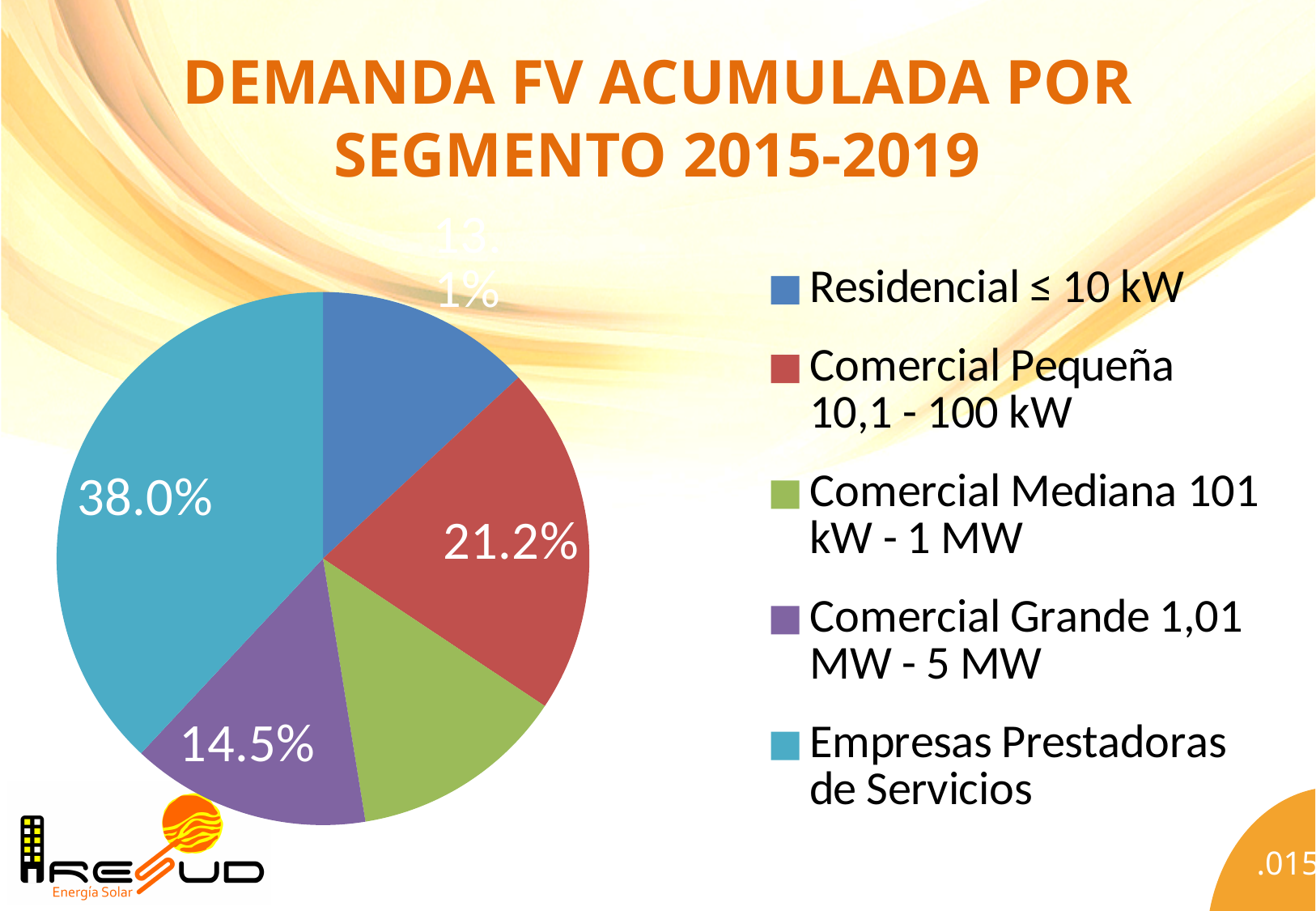
What share of the pie does Residencial ≤ 10 kW represent? 13.1% What is the difference in percentage points between the Comercial Pequeña 10,1 - 100 kW share and the Comercial Grande 1,01 MW - 5 MW share? 6.7 percentage points Which segment has the largest share of the pie? Empresas Prestadoras de Servicios Which has a larger share: Comercial Pequeña 10,1 - 100 kW or Comercial Grande 1,01 MW - 5 MW? Comercial Pequeña 10,1 - 100 kW What share of the pie does Comercial Pequeña 10,1 - 100 kW represent? 21.2% What kind of chart is shown on the slide? Pie chart What share of the pie does Empresas Prestadoras de Servicios represent? 38.0% What colour is the Residencial ≤ 10 kW slice in the pie chart? Blue How many segments does the pie chart have? 5 What share of the pie does Comercial Grande 1,01 MW - 5 MW represent? 14.5% What is the title of the slide containing the pie chart? DEMANDA FV ACUMULADA POR SEGMENTO 2015-2019 What is the difference in percentage points between the Empresas Prestadoras de Servicios share and the Comercial Pequeña 10,1 - 100 kW share? 16.8 percentage points